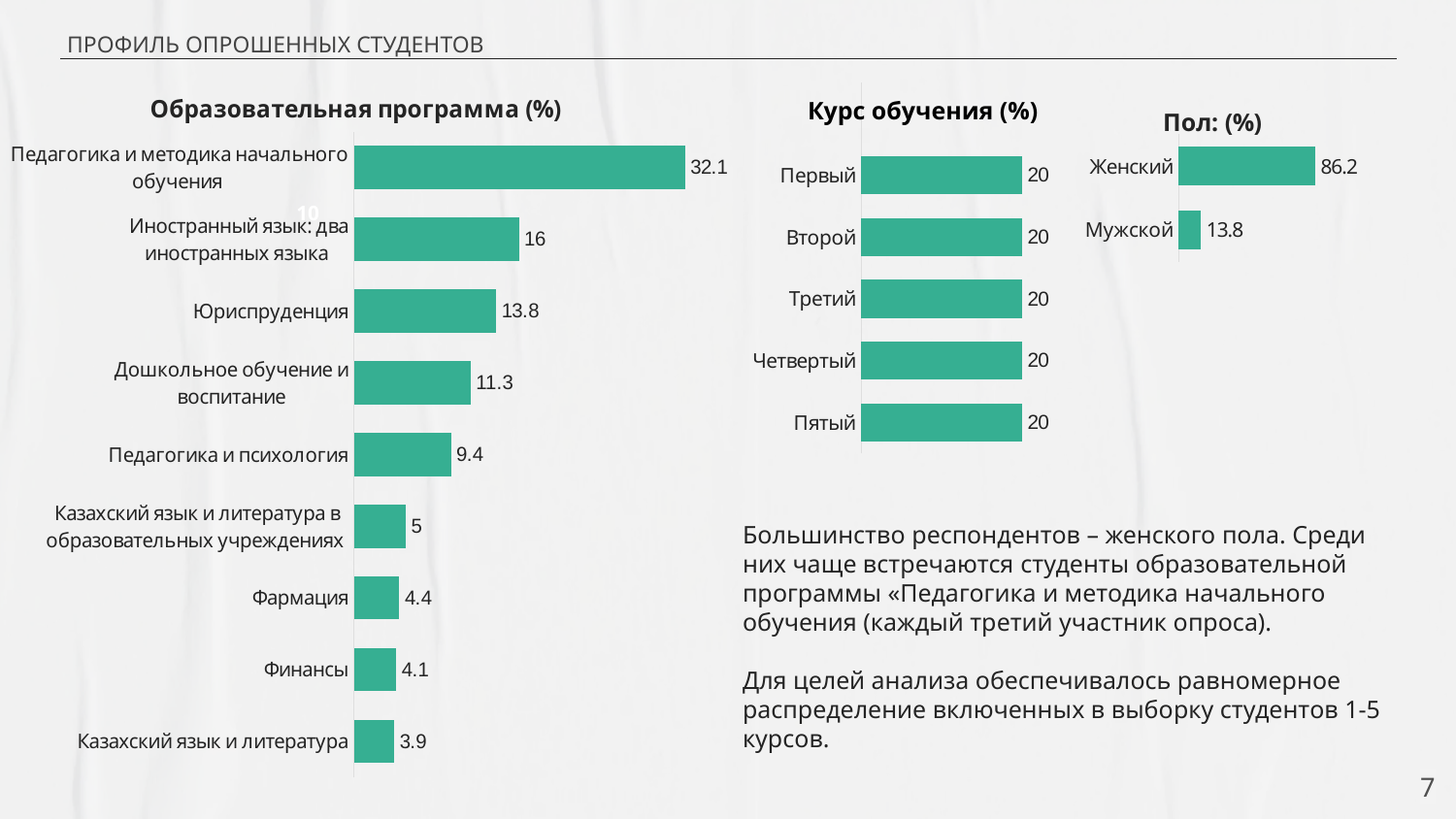
In the chart 'Образовательная программа (%)', which category has the highest value? Педагогика и методика начального обучения In the chart 'Пол: (%)', what is the difference between the values for Женский and Мужской? 72.4 In the chart 'Курс обучения (%)', what is the value for Третий? 20 In the chart 'Пол: (%)', what is the value for Женский? 86.2 In the chart 'Образовательная программа (%)', what is the difference between the values for Иностранный язык: два иностранных языка and Фармация? 11.6 In the chart 'Образовательная программа (%)', which is larger: Дошкольное обучение и воспитание or Педагогика и психология? Дошкольное обучение и воспитание What kind of chart is 'Образовательная программа (%)'? Bar chart How many charts are shown on the slide? 3 How many categories are shown in the chart 'Курс обучения (%)'? 5 In the chart 'Образовательная программа (%)', which category has the lowest value? Казахский язык и литература In the chart 'Образовательная программа (%)', what is the value for Юриспруденция? 13.8 How many categories are shown in the chart 'Образовательная программа (%)'? 9